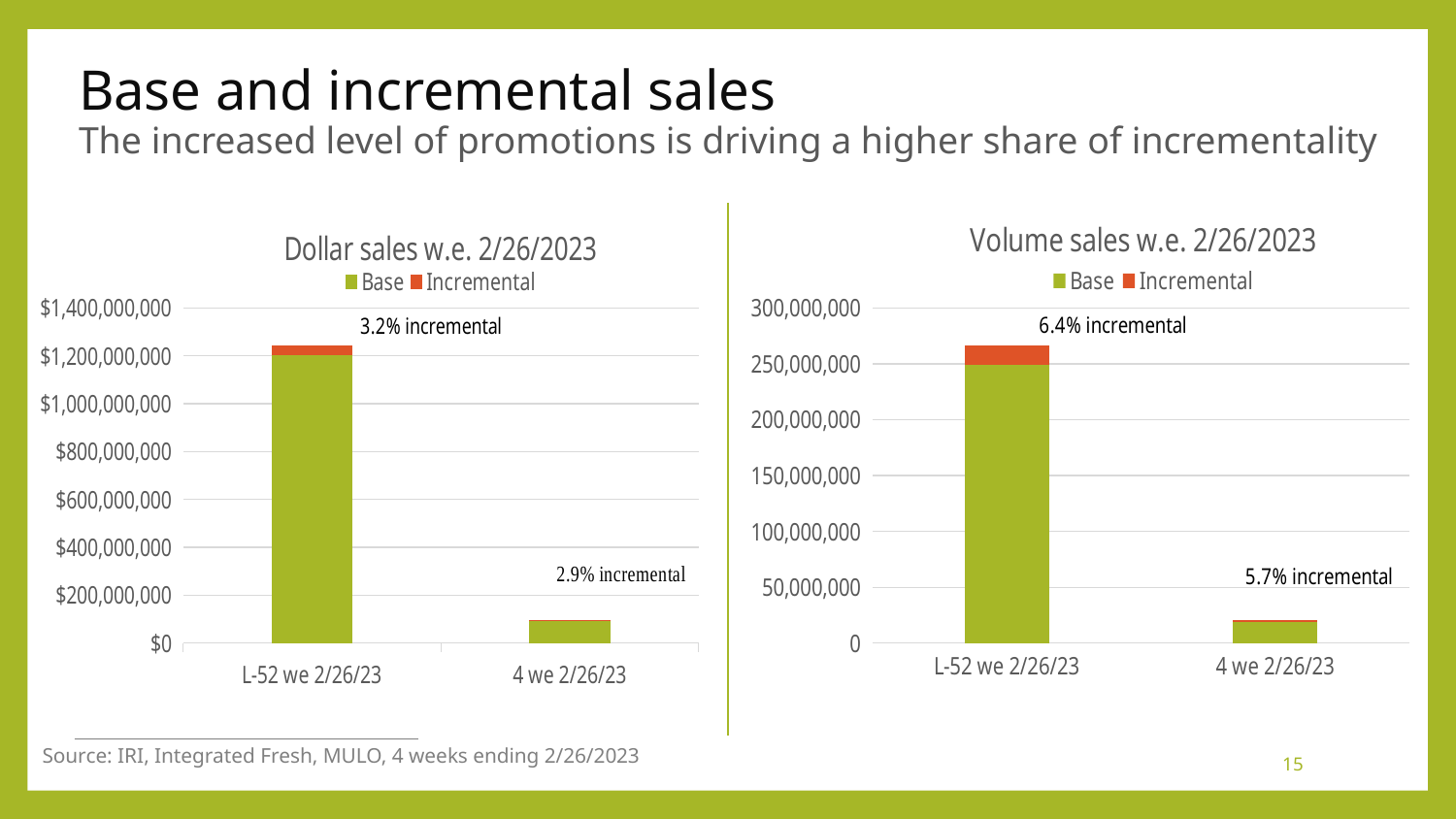
In the Dollar sales w.e. 2/26/2023 chart, what incremental percentage is labelled for L-52 we 2/26/23? 3.2% incremental In the Volume sales w.e. 2/26/2023 chart, is the total bar for L-52 we 2/26/23 greater or less than 250,000,000? greater In the Volume sales w.e. 2/26/2023 chart, what incremental percentage is labelled for L-52 we 2/26/23? 6.4% incremental In the Dollar sales w.e. 2/26/2023 chart, is the total bar for 4 we 2/26/23 greater or less than $200,000,000? less In the Volume sales w.e. 2/26/2023 chart, which period has the higher labelled incremental percentage, L-52 we 2/26/23 or 4 we 2/26/23? L-52 we 2/26/23 In the Volume sales w.e. 2/26/2023 chart, what incremental percentage is labelled for 4 we 2/26/23? 5.7% incremental In the Dollar sales w.e. 2/26/2023 chart, is the total bar for L-52 we 2/26/23 greater or less than $1,000,000,000? greater How many categories are shown on the x axis of the Dollar sales w.e. 2/26/2023 chart? 2 What are the two legend entries in the Dollar sales w.e. 2/26/2023 chart? Base and Incremental What kind of chart is the Dollar sales w.e. 2/26/2023 chart? Stacked bar chart How many series does the legend of the Volume sales w.e. 2/26/2023 chart list? 2 In the Dollar sales w.e. 2/26/2023 chart, what incremental percentage is labelled for 4 we 2/26/23? 2.9% incremental